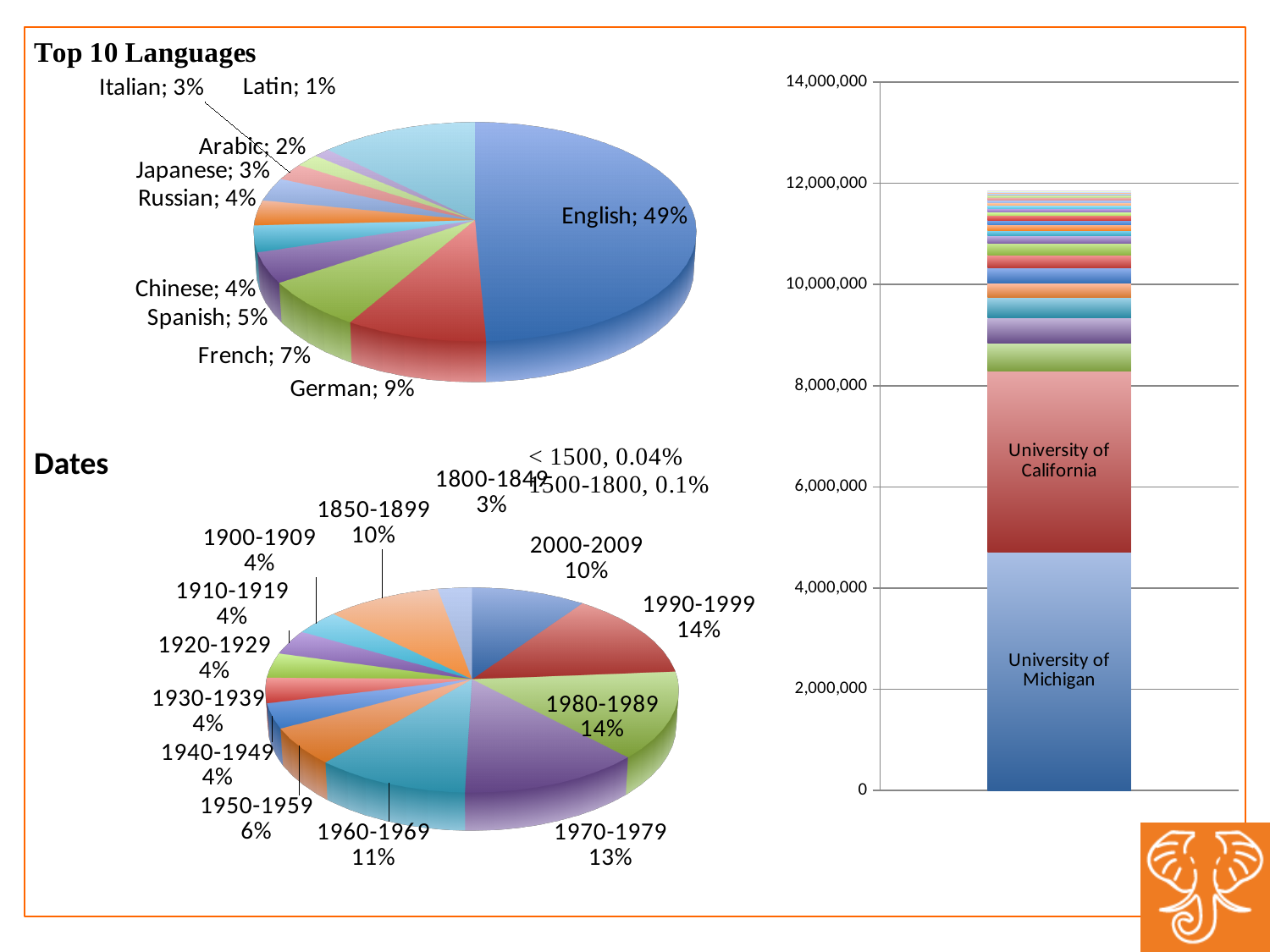
In the "Dates" chart, what is the value for 1970-1979? 13% In the "Top 10 Languages" chart, what is the value for German? 9% What kind of chart is the "Top 10 Languages" chart? pie chart In the "Dates" chart, what is the difference between the shares of 1960-1969 and 1950-1959? 5% In the "Top 10 Languages" chart, what is the difference between the shares of French and Spanish? 2% In the "Top 10 Languages" chart, what share does English have? 49% In the "Top 10 Languages" chart, which is larger, the share for Russian or the share for Arabic? Russian In the "Dates" chart, which period has the smallest share? < 1500 What kind of chart is the chart on the right side of the slide? bar chart In the "Top 10 Languages" chart, which language has the smallest share? Latin In the stacked bar chart on the right, is the value for University of Michigan greater or less than 4,000,000? greater